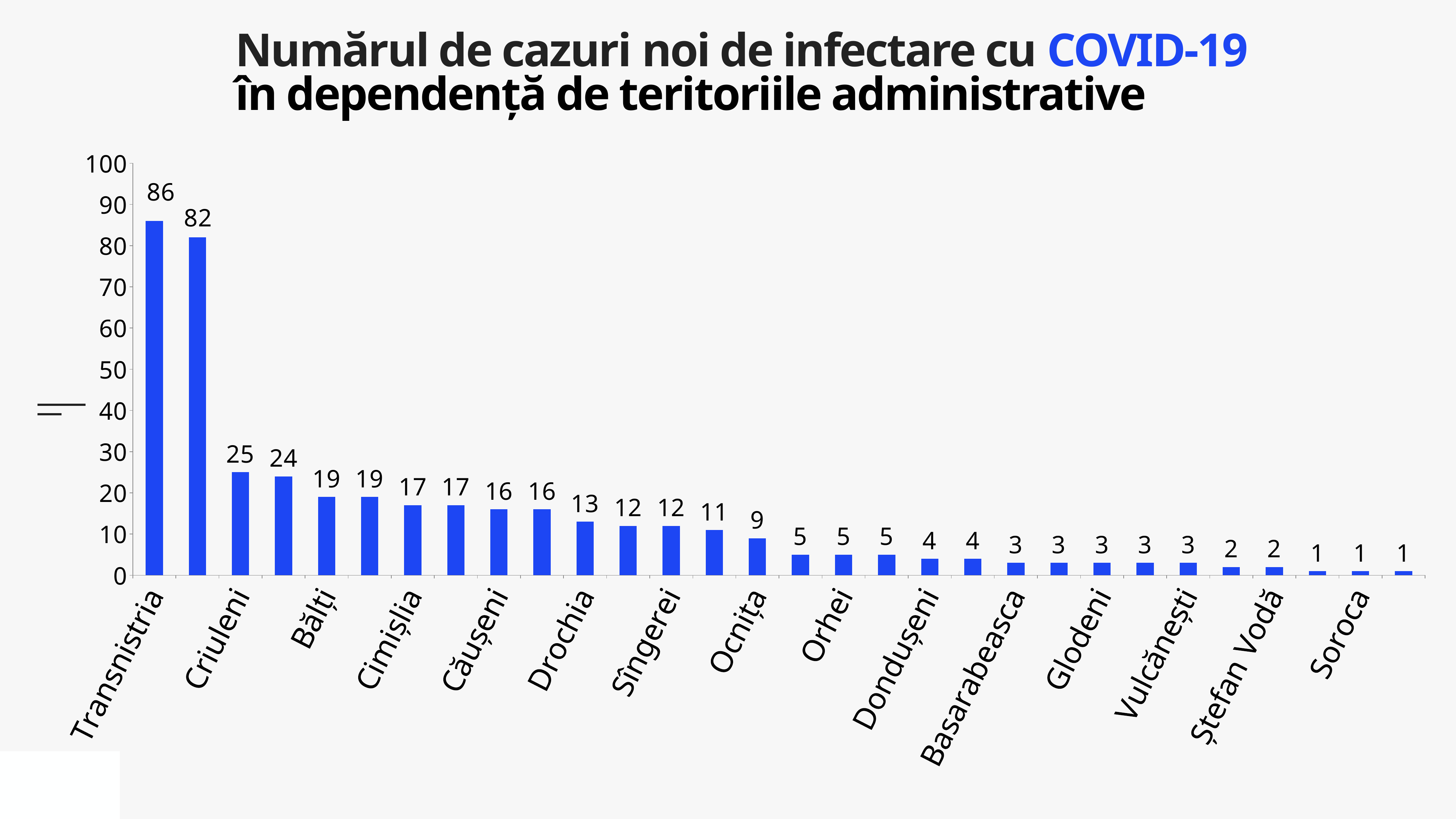
What is the value for Transnistria? 86 What is the value for Bălți? 19 What is the value for Criuleni? 25 What is the value for Drochia? 13 What kind of chart is shown on the slide? bar chart Which labelled territory has the highest number of new cases? Transnistria What is the value for Soroca? 1 What is the difference between the values for Transnistria and Criuleni? 61 Do the values rise or fall from left to right along the x axis? fall Is the value for Transnistria greater or less than 80? greater What is the value for Ocnița? 9 Which is larger, the value for Cimișlia or the value for Căușeni? Cimișlia